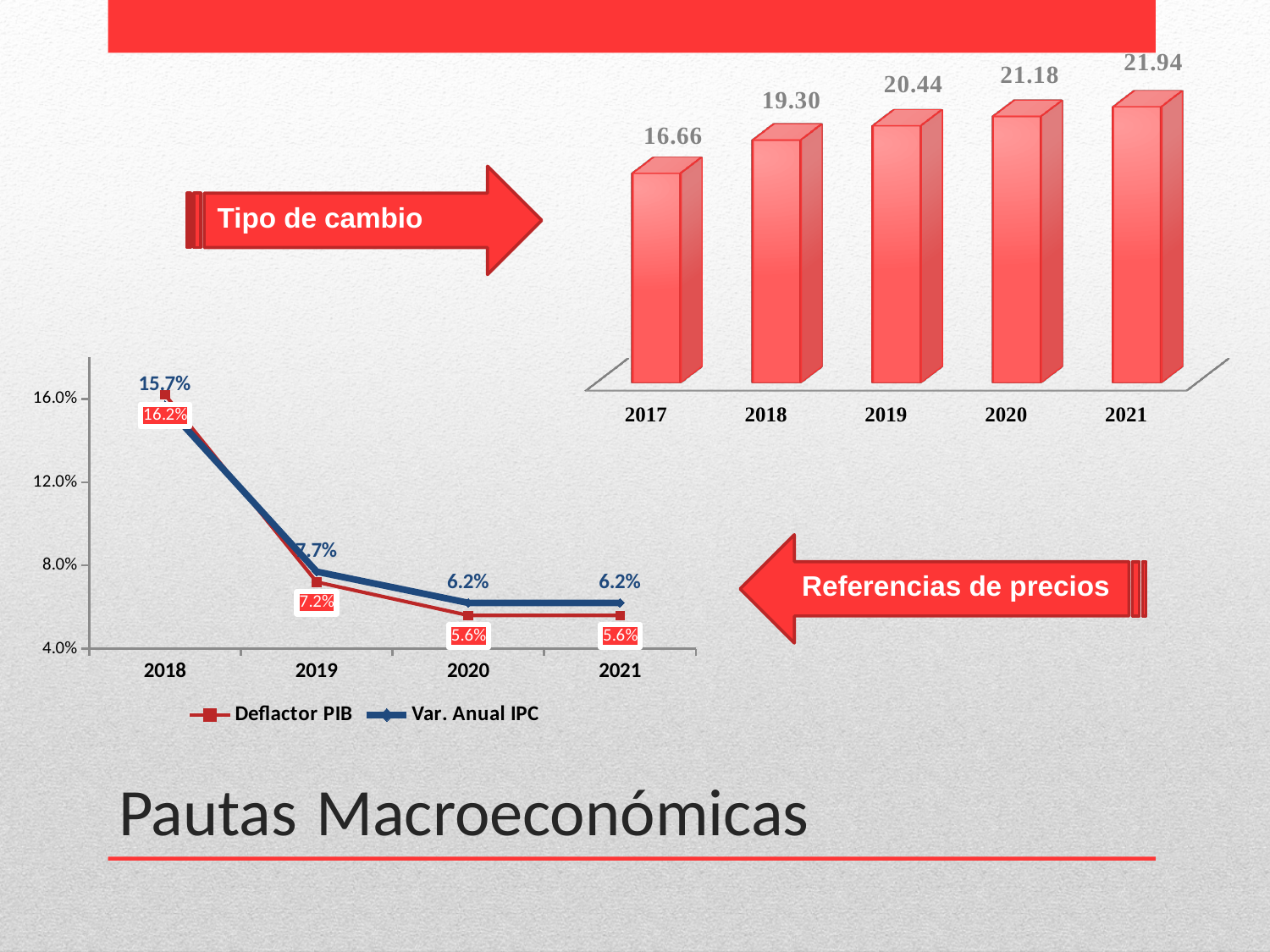
In the bottom-left line chart (Referencias de precios), what is the Var. Anual IPC value for 2019? 7.7% In the top-right bar chart (Tipo de cambio), how many years are shown? 5 In the top-right bar chart (Tipo de cambio), do the values rise or fall from 2017 to 2021? rise In the top-right bar chart (Tipo de cambio), what is the value for 2019? 20.44 In the bottom-left line chart (Referencias de precios), what is the Deflactor PIB value for 2018? 16.2% What type of chart is shown in the top-right of the slide? bar chart In the bottom-left line chart (Referencias de precios), how many series does the legend list? 2 In the top-right bar chart (Tipo de cambio), which year has the highest value? 2021 In the top-right bar chart (Tipo de cambio), what is the difference between the 2021 and 2017 values? 5.28 In the bottom-left line chart (Referencias de precios), what is the difference between Var. Anual IPC and Deflactor PIB in 2020? 0.6% In the bottom-left line chart (Referencias de precios), which series has the higher value in 2021, Deflactor PIB or Var. Anual IPC? Var. Anual IPC In the top-right bar chart (Tipo de cambio), which year has the lowest value? 2017